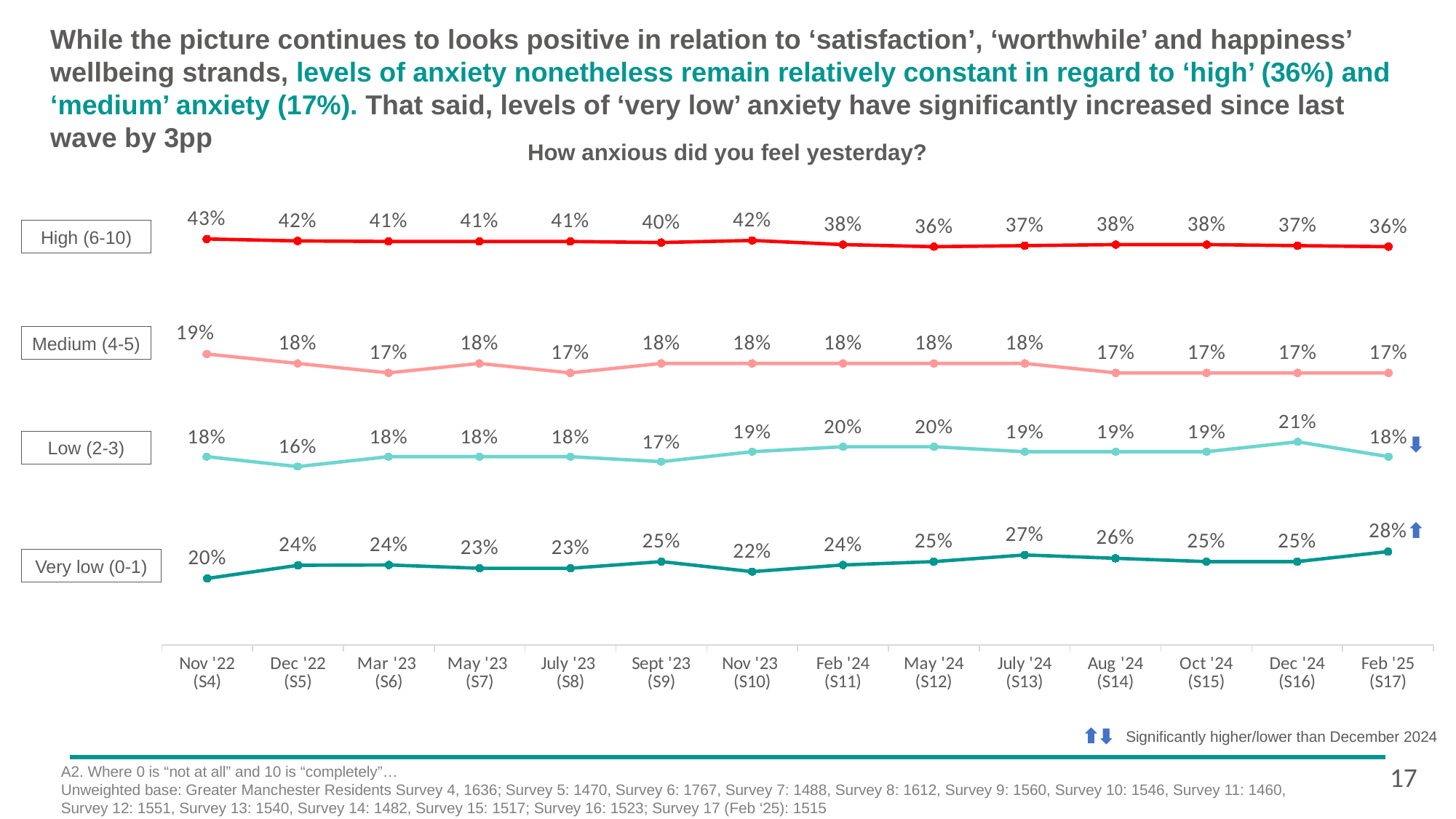
By how many percentage points did High (6-10) change between Nov '22 (S4) and Feb '25 (S17)? 7 percentage points In which survey wave is the Low (2-3) series at its lowest? Dec '22 (S5) What is the value for Very low (0-1) in Nov '22 (S4)? 20% In Feb '25 (S17), which is larger: Very low (0-1) or Low (2-3)? Very low (0-1) How many survey waves are plotted on the x axis? 14 What is the difference between Very low (0-1) in Dec '24 (S16) and Feb '25 (S17)? 3 percentage points What kind of chart is shown on the slide? Line chart In which survey wave is the Very low (0-1) series at its highest? Feb '25 (S17) How many series are plotted on the chart? 4 What is the value for High (6-10) in Feb '25 (S17)? 36% Does the High (6-10) series generally rise or fall from Nov '22 to Feb '25? Fall What is the value for Medium (4-5) in Mar '23 (S6)? 17%